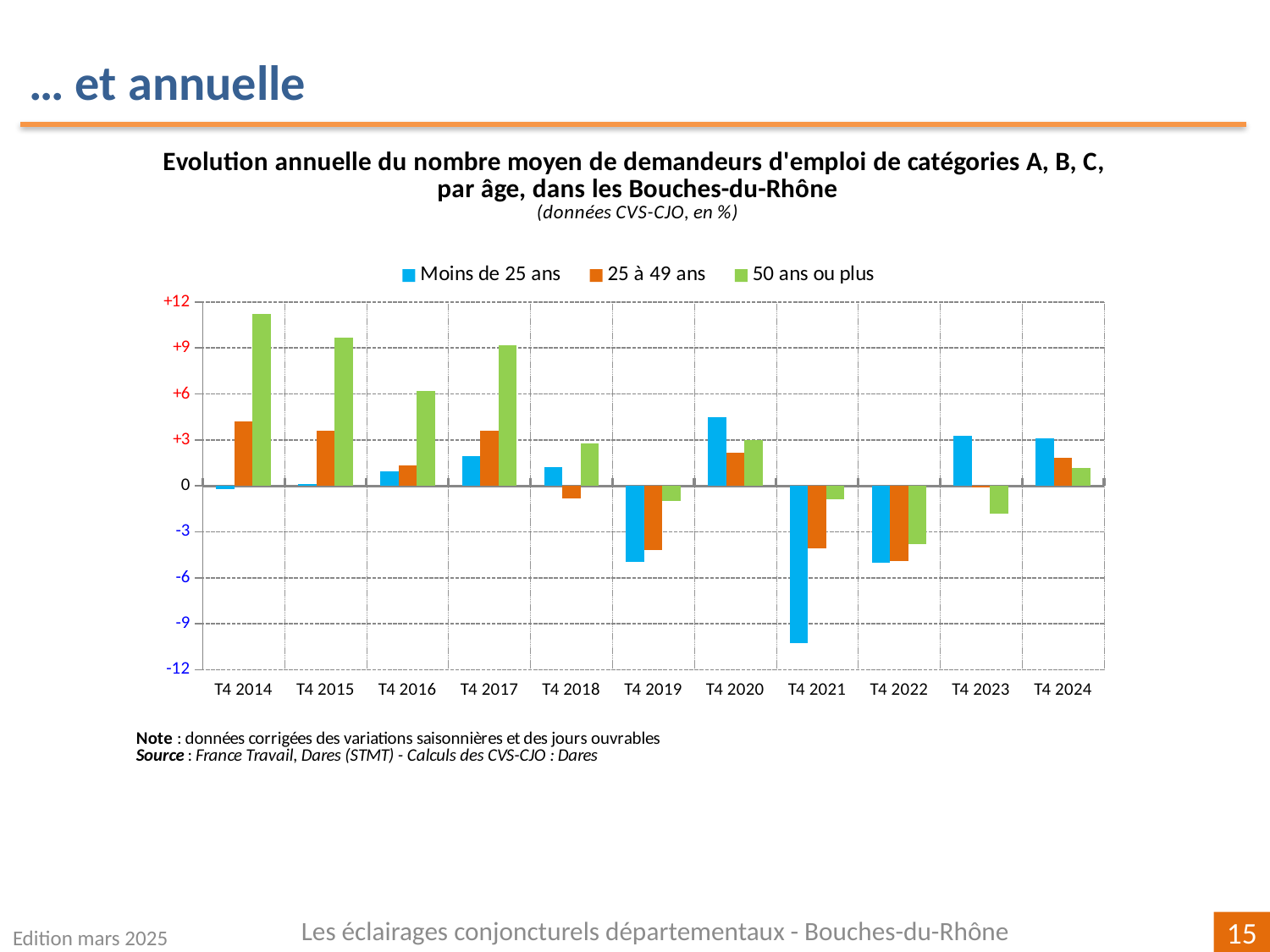
What kind of chart is shown on the slide? Bar chart For the series '50 ans ou plus', which quarter has the highest value? T4 2014 For the series 'Moins de 25 ans', which quarter has the lowest value? T4 2021 In T4 2017, which series has the larger value: '25 à 49 ans' or '50 ans ou plus'? 50 ans ou plus For the series 'Moins de 25 ans', which quarter has the highest value? T4 2020 In T4 2020, which series has the larger value: 'Moins de 25 ans' or '50 ans ou plus'? Moins de 25 ans Is the value for '50 ans ou plus' in T4 2022 greater or less than -3? less How many series does the legend list? 3 What colour represents the series '50 ans ou plus' in the legend? Green Is the value for '50 ans ou plus' in T4 2014 greater or less than +9? greater How many quarters (categories) are shown on the x axis? 11 Is the value for 'Moins de 25 ans' in T4 2021 greater or less than -9? less